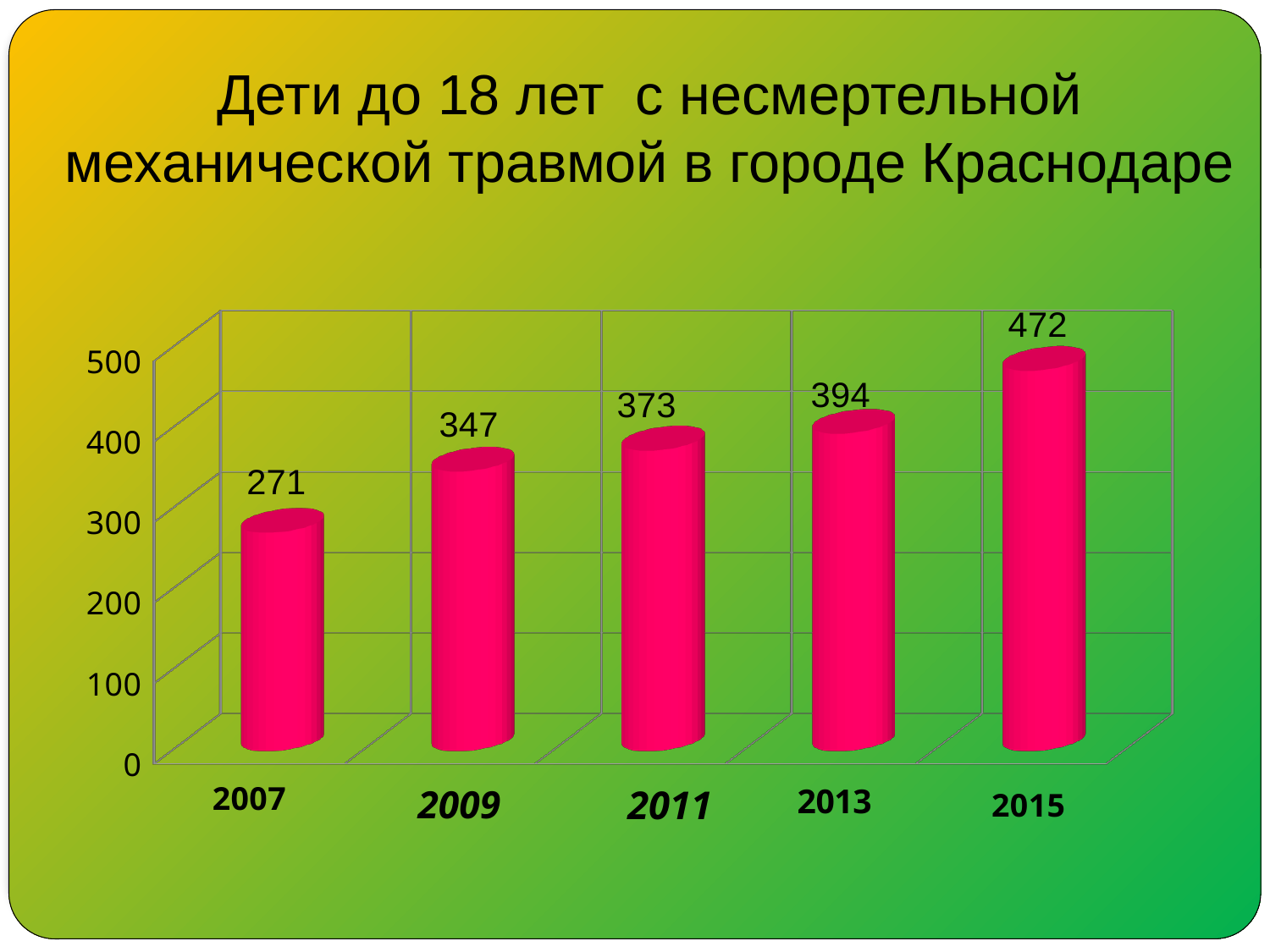
Do the values rise or fall from 2007 to 2015? rise How many years are shown on the chart? 5 Which year has the lowest value? 2007 Which is larger, the value for 2009 or the value for 2013? 2013 What is the difference between the values for 2015 and 2007? 201 What is the difference between the values for 2013 and 2011? 21 Which year has the highest value? 2015 What is the value for 2011? 373 What is the value for 2015? 472 What is the value for 2007? 271 Is the value for 2009 greater or less than 300? greater What kind of chart is shown on the slide? bar chart